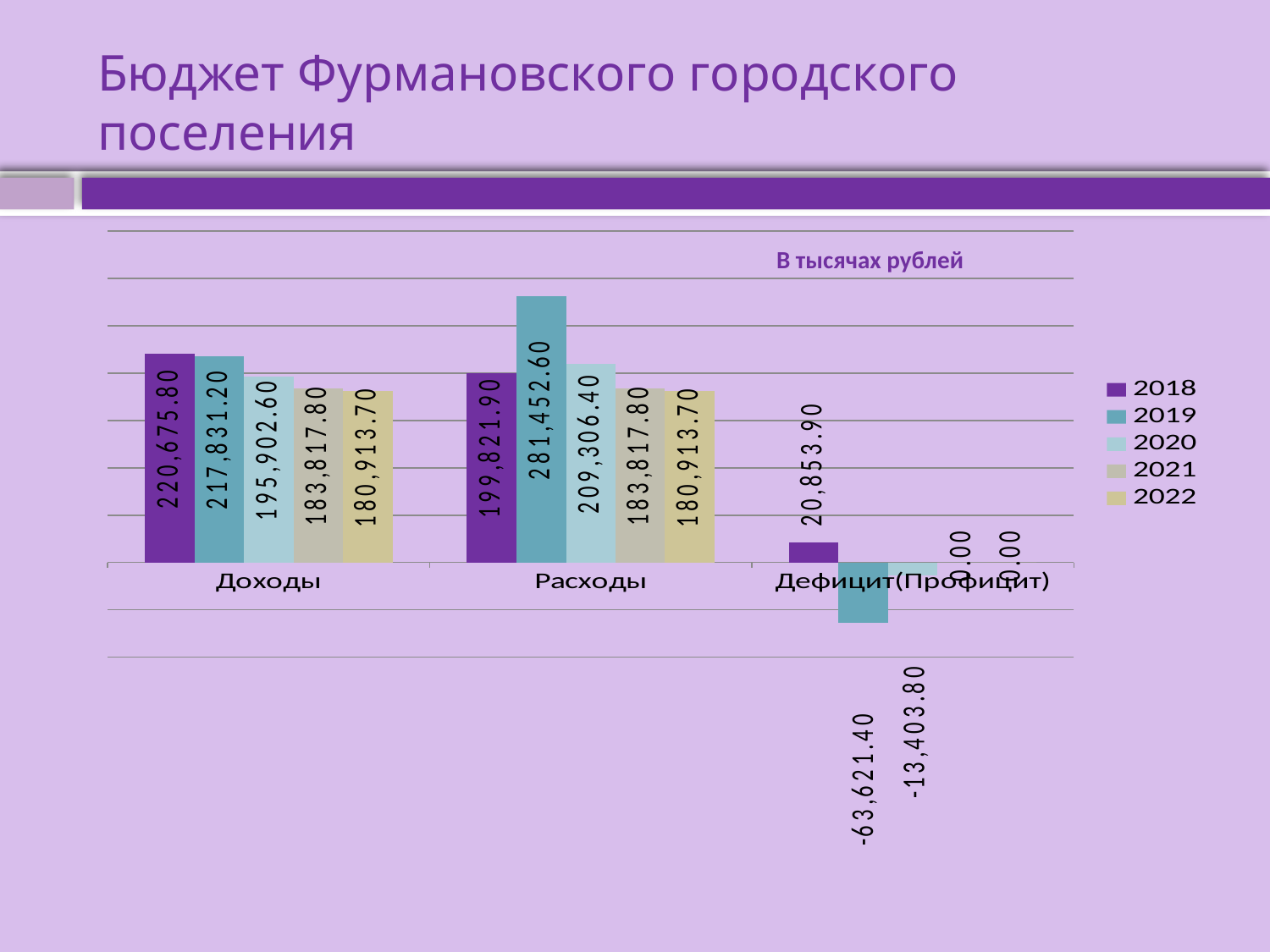
What type of chart is shown on the slide? bar chart Which is larger in 2020: Доходы or Расходы? Расходы How many series does the legend list? 5 What is the value for Доходы in 2018? 220,675.80 What unit is stated in the chart's note? В тысячах рублей Which year has the lowest value for Доходы? 2022 Which year has the highest value for Расходы? 2019 What is the value for Расходы in 2019? 281,452.60 What is the difference between Доходы and Расходы in 2018? 20,853.90 How many categories are shown on the x axis? 3 What is the value for Доходы in 2022? 180,913.70 What is the value for Дефицит(Профицит) in 2020? -13,403.80